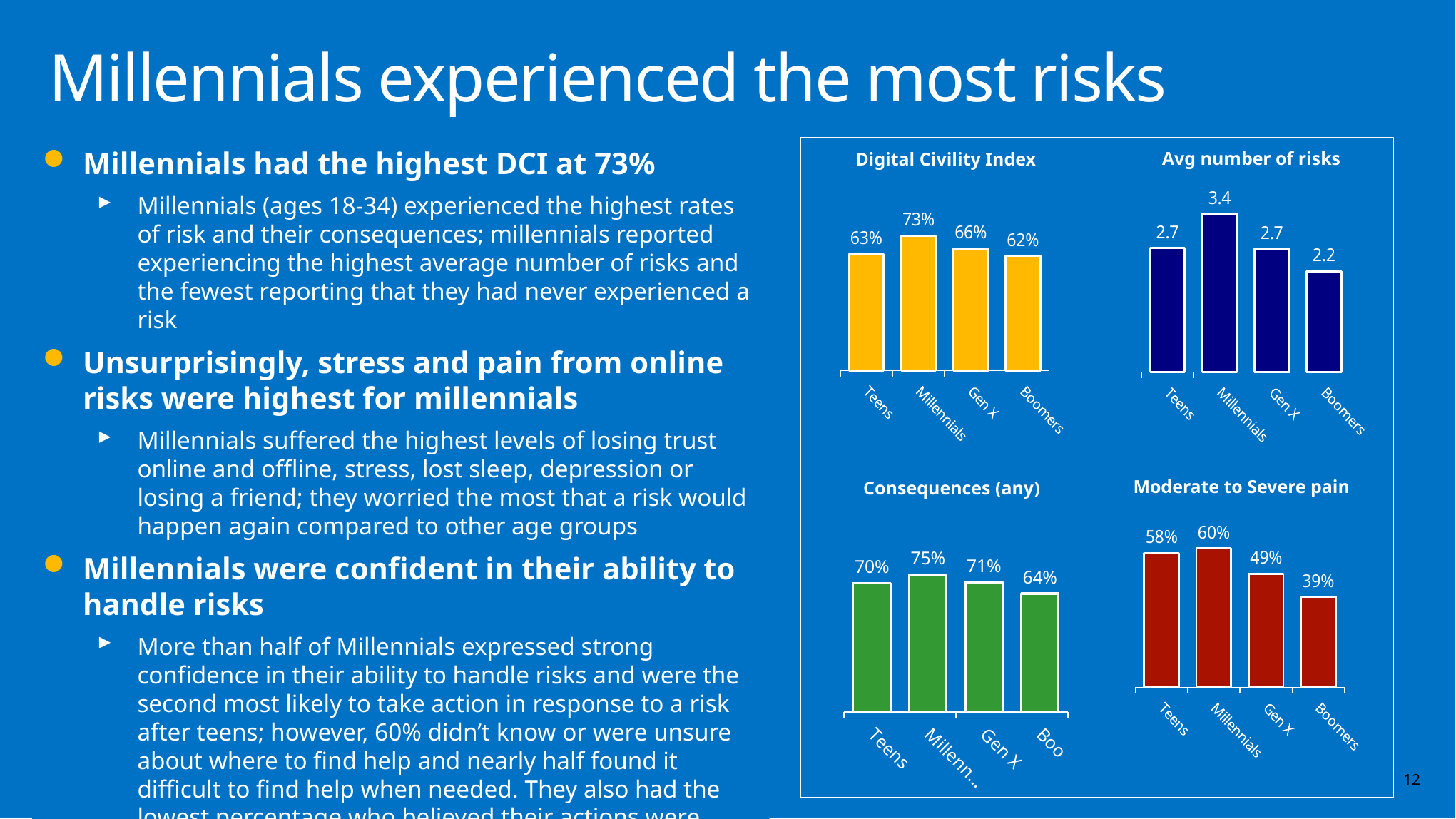
In the Avg number of risks chart, what is the value for Boomers? 2.2 In the Moderate to Severe pain chart, what is the difference between Millennials and Boomers? 21% In the Moderate to Severe pain chart, what is the value for Gen X? 49% In the Avg number of risks chart, what is the difference between Millennials and Teens? 0.7 What type of chart is the Consequences (any) chart? Bar chart In the Digital Civility Index chart, what is the value for Millennials? 73% In the Avg number of risks chart, which category has the highest value? Millennials In the Consequences (any) chart, what is the value for Teens? 70% In the Moderate to Severe pain chart, which category has the lowest value? Boomers In the Consequences (any) chart, which is larger, Gen X or Boomers? Gen X How many bars are in the Digital Civility Index chart? 4 In the Digital Civility Index chart, which category has the lowest value? Boomers